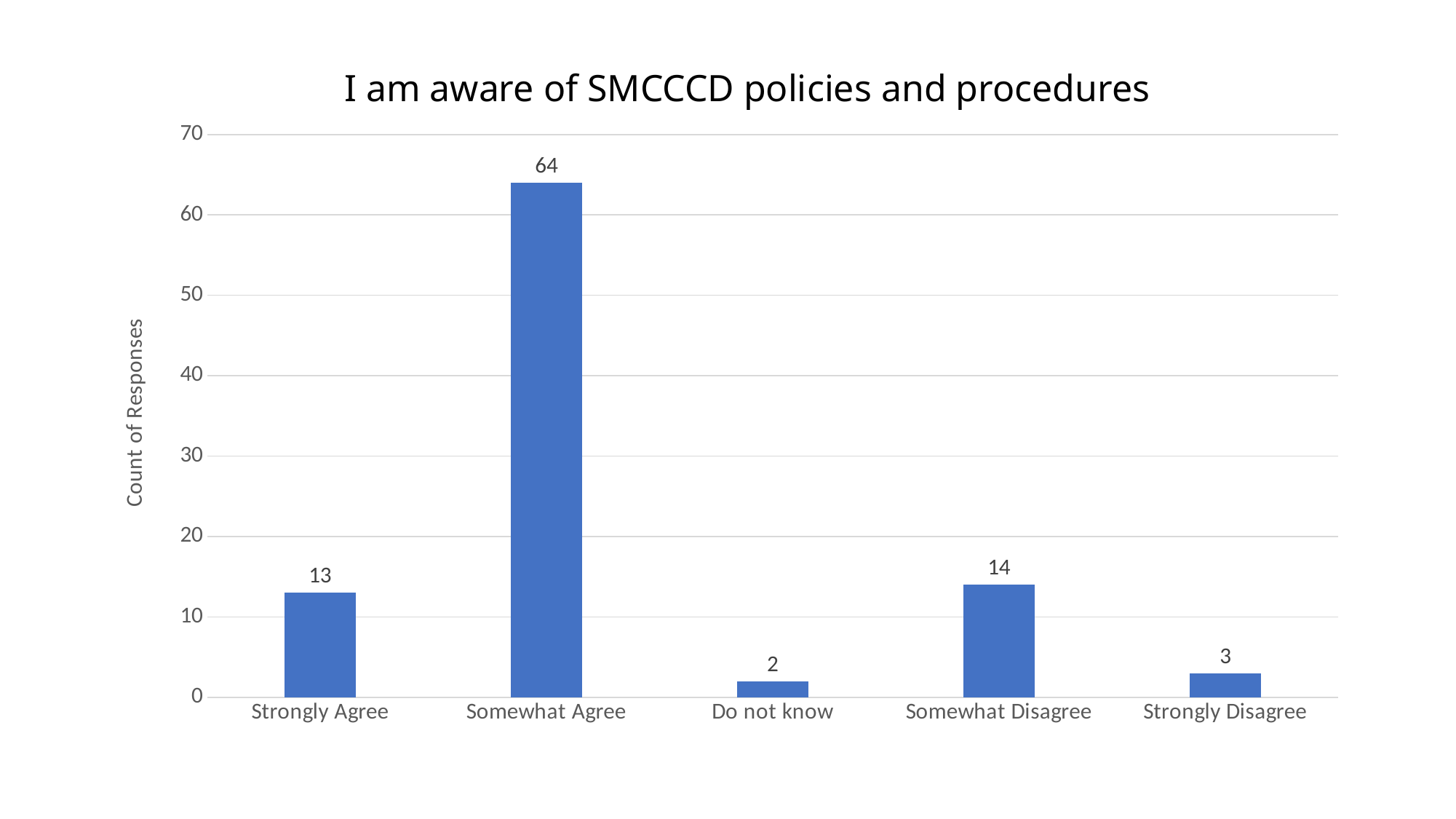
What is the count of responses for Do not know? 2 What is the title of the chart? I am aware of SMCCCD policies and procedures Which has a higher count, Strongly Agree or Somewhat Disagree? Somewhat Disagree What kind of chart is shown on the slide? Bar chart Is the value for Somewhat Agree greater or less than 60? greater What is the count of responses for Strongly Agree? 13 Which response category has the highest count? Somewhat Agree What is the count of responses for Strongly Disagree? 3 What is the count of responses for Somewhat Agree? 64 What is the difference between the counts for Somewhat Agree and Somewhat Disagree? 50 How many response categories are shown on the x axis? 5 Which response category has the lowest count? Do not know